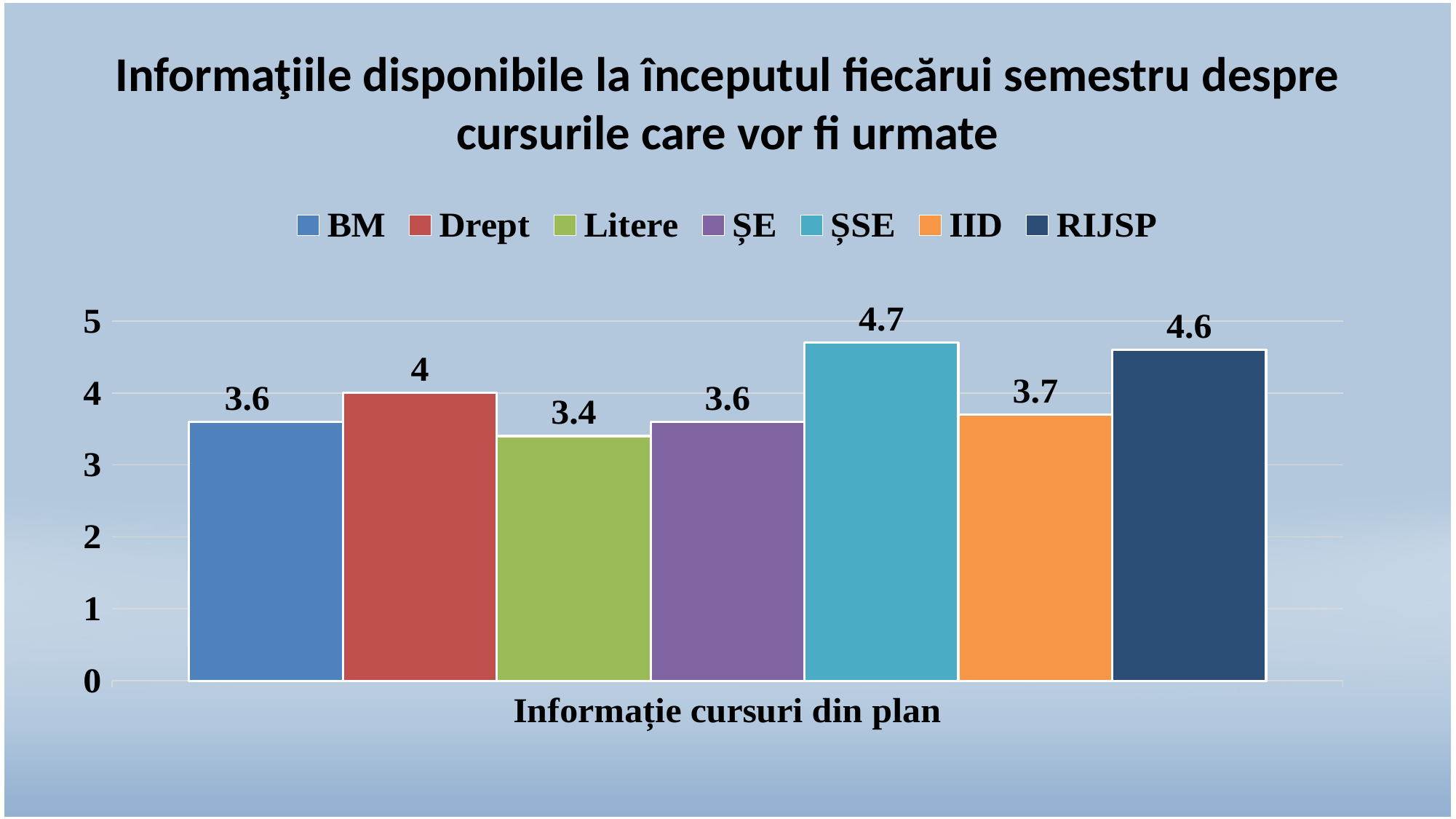
What is the value for Litere? 3.4 What is the value for Drept? 4 What is the difference between the values for ȘSE and Litere? 1.3 What is the value for ȘSE? 4.7 What kind of chart is shown on the slide? Bar chart Which is larger, the value for RIJSP or the value for IID? RIJSP Which series has the highest value? ȘSE Which series has the lowest value? Litere What is the label on the x axis of the chart? Informație cursuri din plan What is the difference between the values for RIJSP and Drept? 0.6 How many series does the legend list? 7 What is the value for IID? 3.7